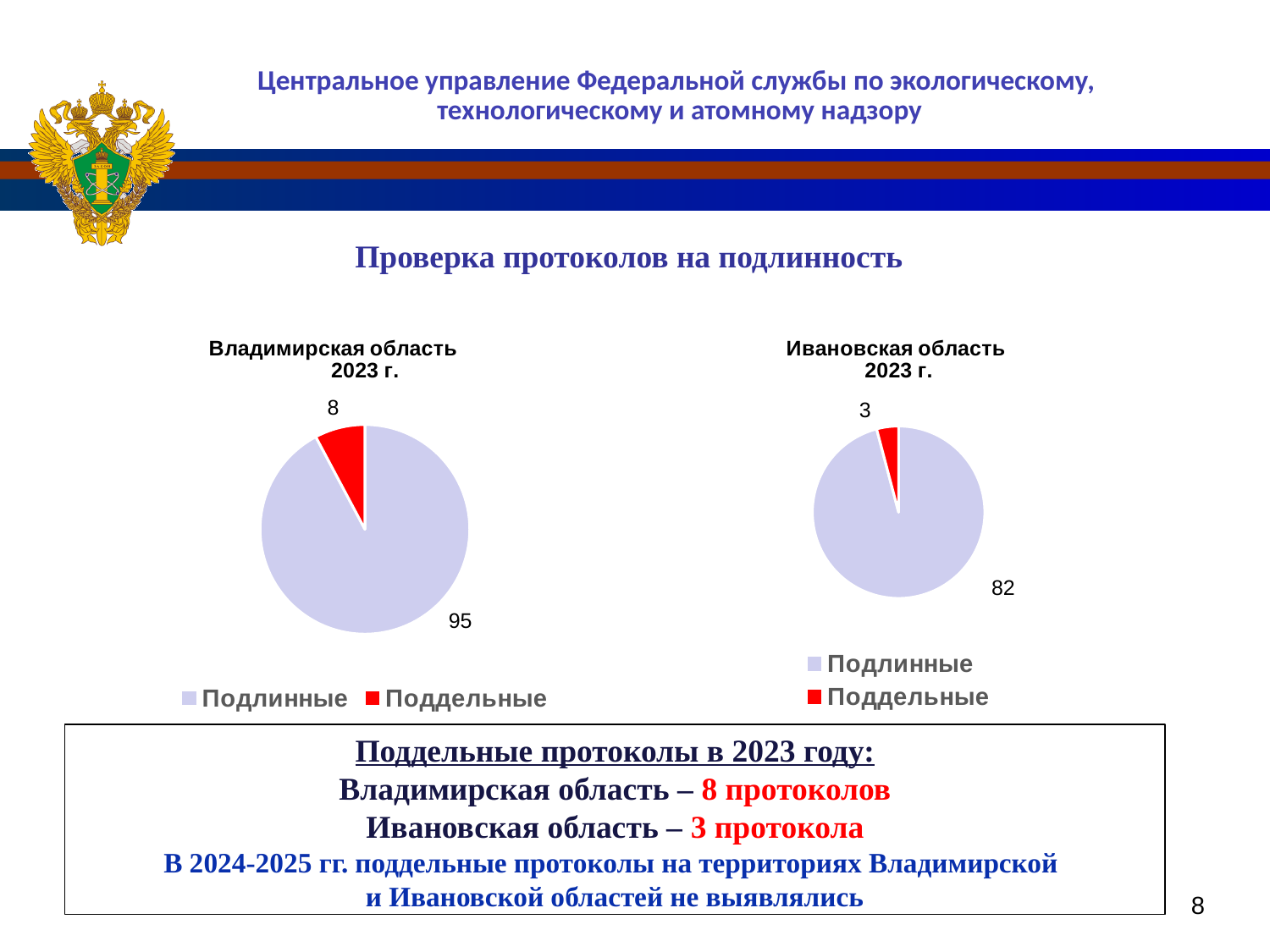
In the Владимирская область 2023 г. chart, what colour is the Поддельные slice? Red Which is larger: Поддельные in the Владимирская область chart or Поддельные in the Ивановская область chart? Владимирская область In the Ивановская область 2023 г. chart, which category is the smallest? Поддельные What type of chart is used for Ивановская область 2023 г.? Pie chart What is the total of all slices in the Ивановская область 2023 г. chart? 85 In the Владимирская область 2023 г. chart, which category is the largest? Подлинные In the Ивановская область 2023 г. pie chart, what is the value for Подлинные? 82 In the Владимирская область 2023 г. pie chart, what is the value for Подлинные? 95 How many slices does the Владимирская область 2023 г. pie chart have? 2 In the Владимирская область 2023 г. pie chart, what is the value for Поддельные? 8 In the Владимирская область 2023 г. chart, what is the difference between Подлинные and Поддельные? 87 In the Ивановская область 2023 г. pie chart, what is the value for Поддельные? 3